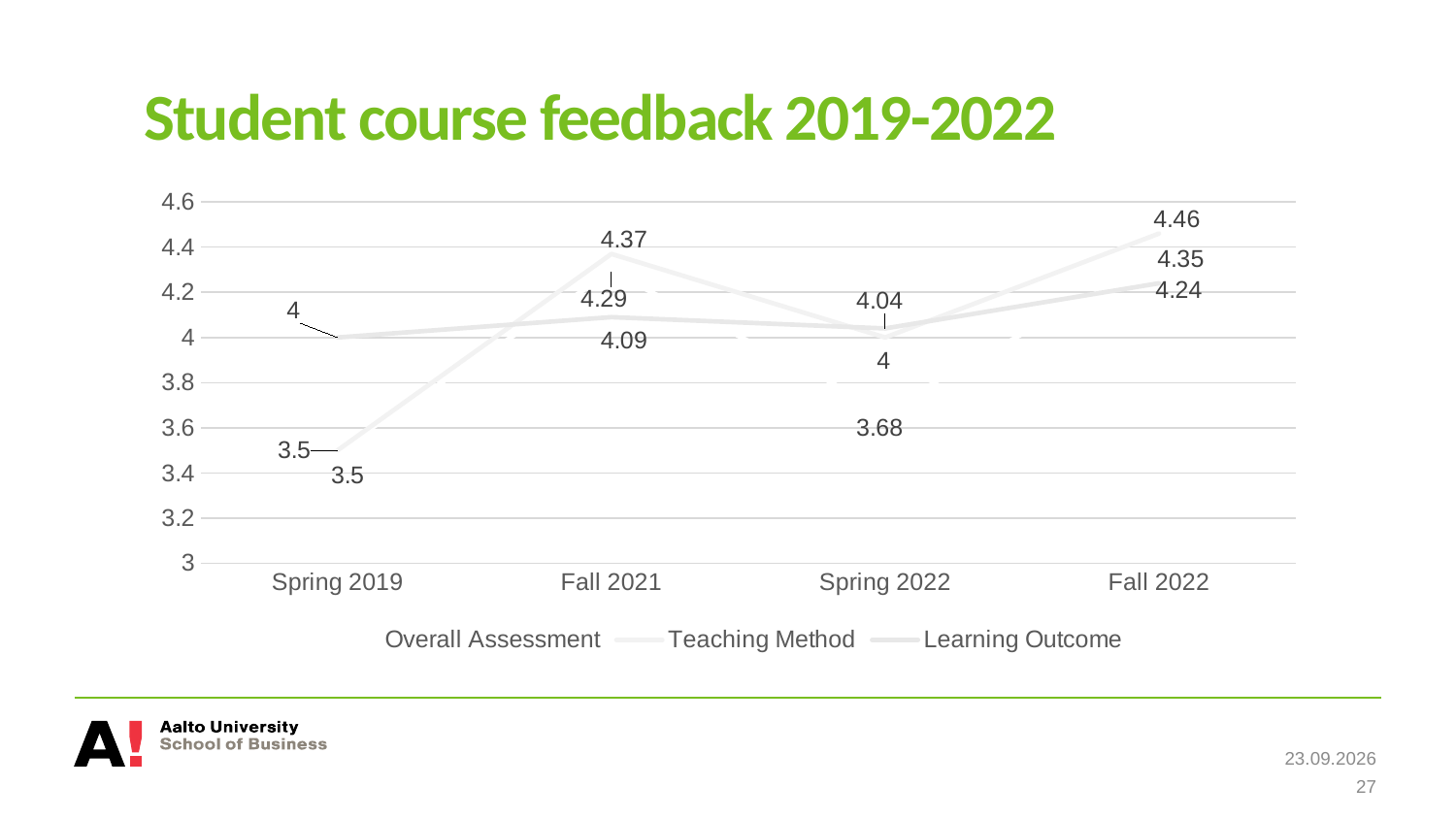
What is the highest value labeled for Fall 2021? 4.37 What is the difference between the highest and lowest labeled values for Fall 2022? 0.22 What is the highest value labeled for Fall 2022? 4.46 What is the title of the chart? Student course feedback 2019-2022 What is the lowest value labeled for Spring 2022? 3.68 How many periods are shown on the x axis? 4 How many series does the legend list? 3 What are the three series named in the legend? Overall Assessment, Teaching Method, Learning Outcome Which is larger, the highest value for Fall 2021 or the highest value for Fall 2022? Fall 2022 What is the difference between the highest and lowest labeled values for Spring 2022? 0.36 Which period has the highest labeled value in the whole chart? Fall 2022 What kind of chart is shown on the slide? line chart